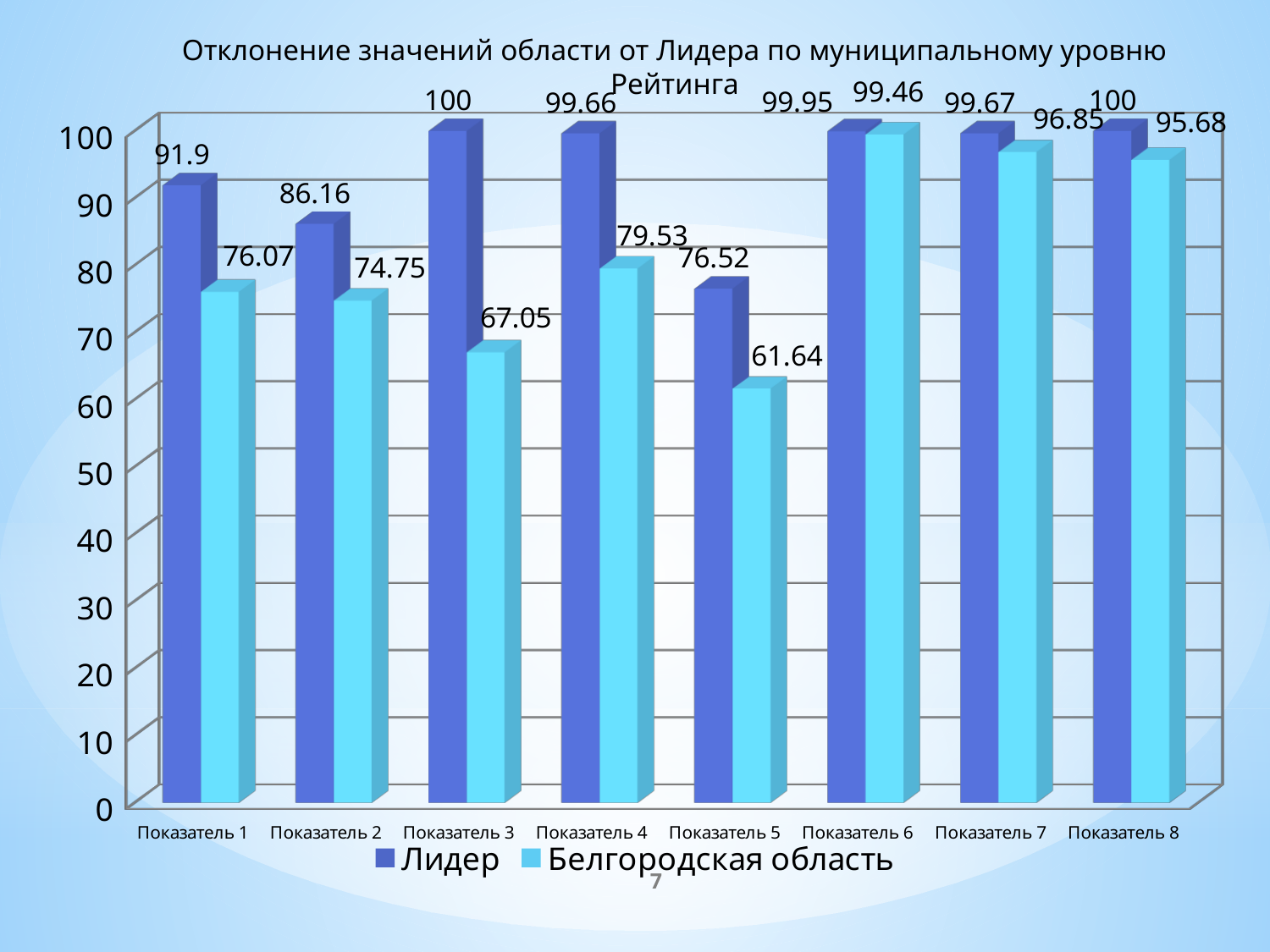
How many series does the legend list? 2 What is the difference between the Лидер and Белгородская область values for Показатель 3? 32.95 Which is larger: the Белгородская область value for Показатель 4 or for Показатель 1? Показатель 4 What kind of chart is shown on the slide? Bar chart Which category has the lowest value for Лидер? Показатель 5 What is the value for Белгородская область for Показатель 7? 96.85 What is the value for Белгородская область for Показатель 3? 67.05 What is the difference between the Лидер and Белгородская область values for Показатель 5? 14.88 How many categories are shown on the x axis? 8 Which series is shown in light blue in the legend? Белгородская область What is the value for Лидер for Показатель 2? 86.16 Which category has the lowest value for Белгородская область? Показатель 5